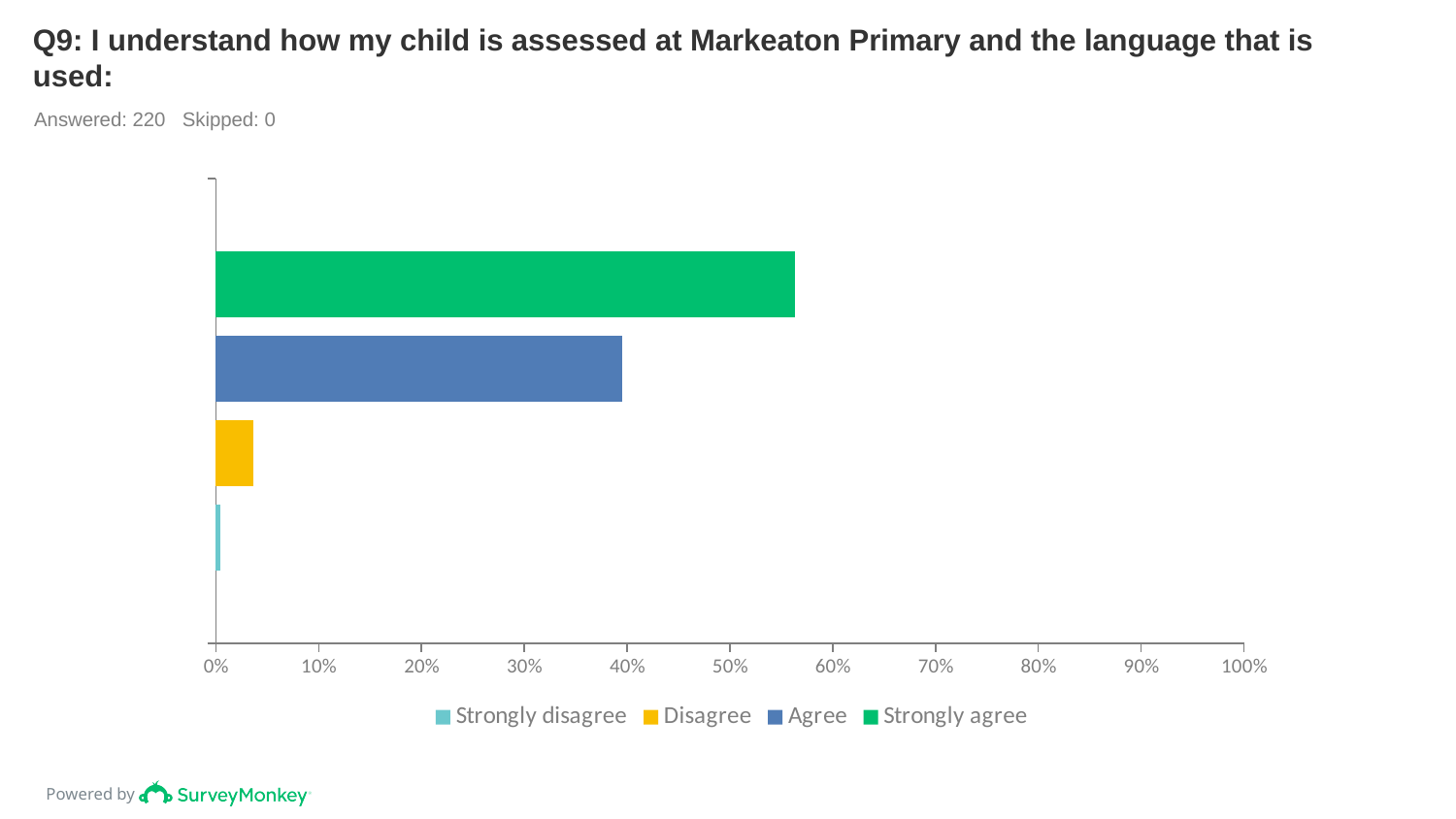
Is the value for Strongly agree greater or less than 60%? less What colour is the bar for Disagree? yellow Which is larger, the value for Strongly agree or the value for Agree? Strongly agree What kind of chart is shown on the slide? bar chart Which response option has the lowest value? Strongly disagree How many respondents answered this question according to the slide? 220 Is the value for Disagree greater or less than 10%? less Is the value for Strongly agree greater or less than 50%? greater Which response option has the highest value? Strongly agree Which is larger, the value for Agree or the value for Disagree? Agree How many response options does the legend list? 4